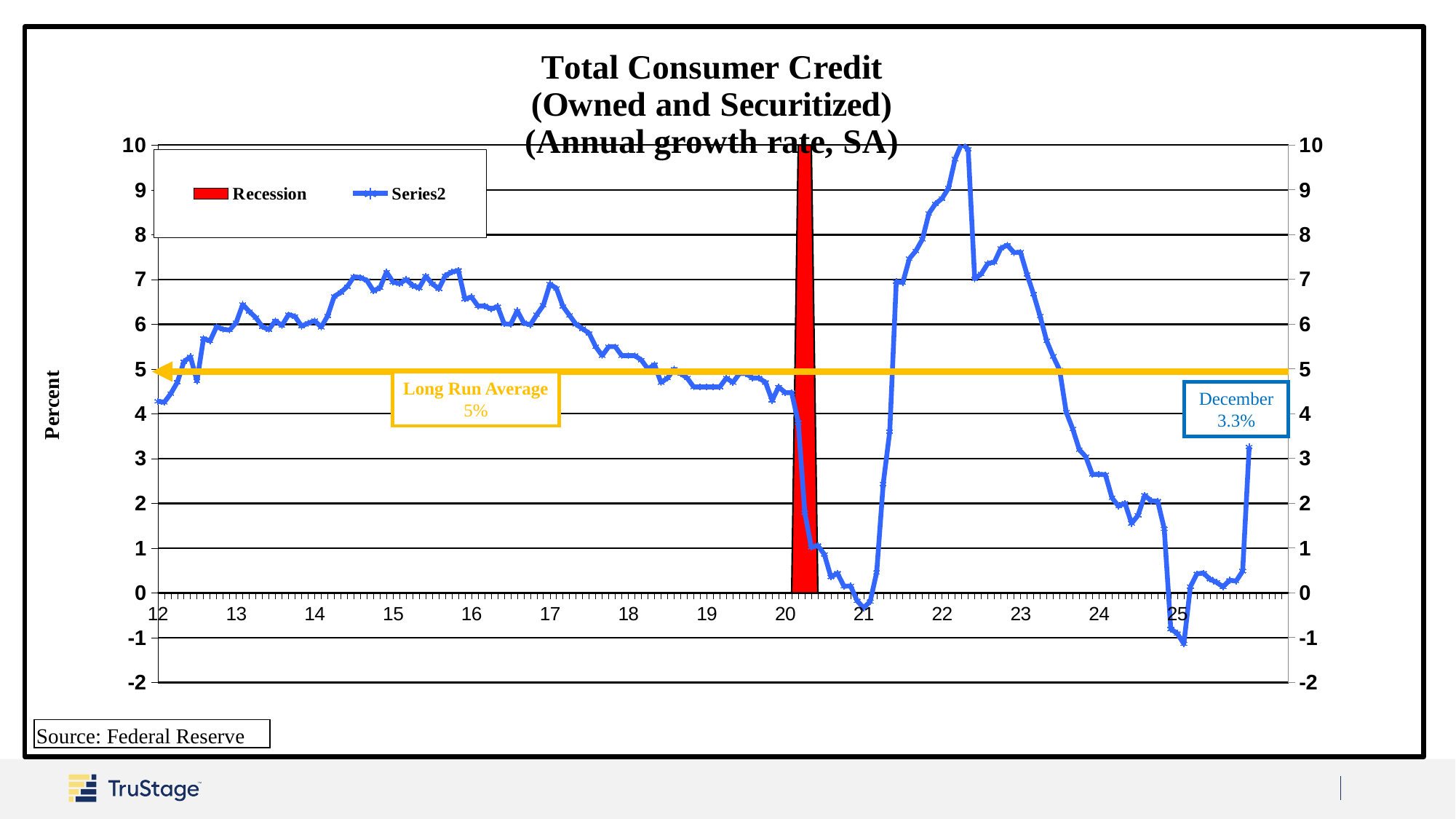
How many entries does the legend list? 2 Is the value at the start of 2015 (x-axis label 15) greater or less than 5? greater What is the title of the chart? Total Consumer Credit (Owned and Securitized) (Annual growth rate, SA) What is the Long Run Average shown on the chart? 5% What kind of chart is shown on the slide? line chart By how much is the Long Run Average above the December value? 1.7 percentage points What is the December value called out on the chart? 3.3% Is the value at the start of 2025 (x-axis label 25) greater or less than 0? less Which is larger, the December value or the Long Run Average? Long Run Average How many year labels are shown on the x axis? 14 Is the value at the start of 2022 (x-axis label 22) greater or less than 5? greater Between 2023 and the start of 2025, does the line generally rise or fall? fall